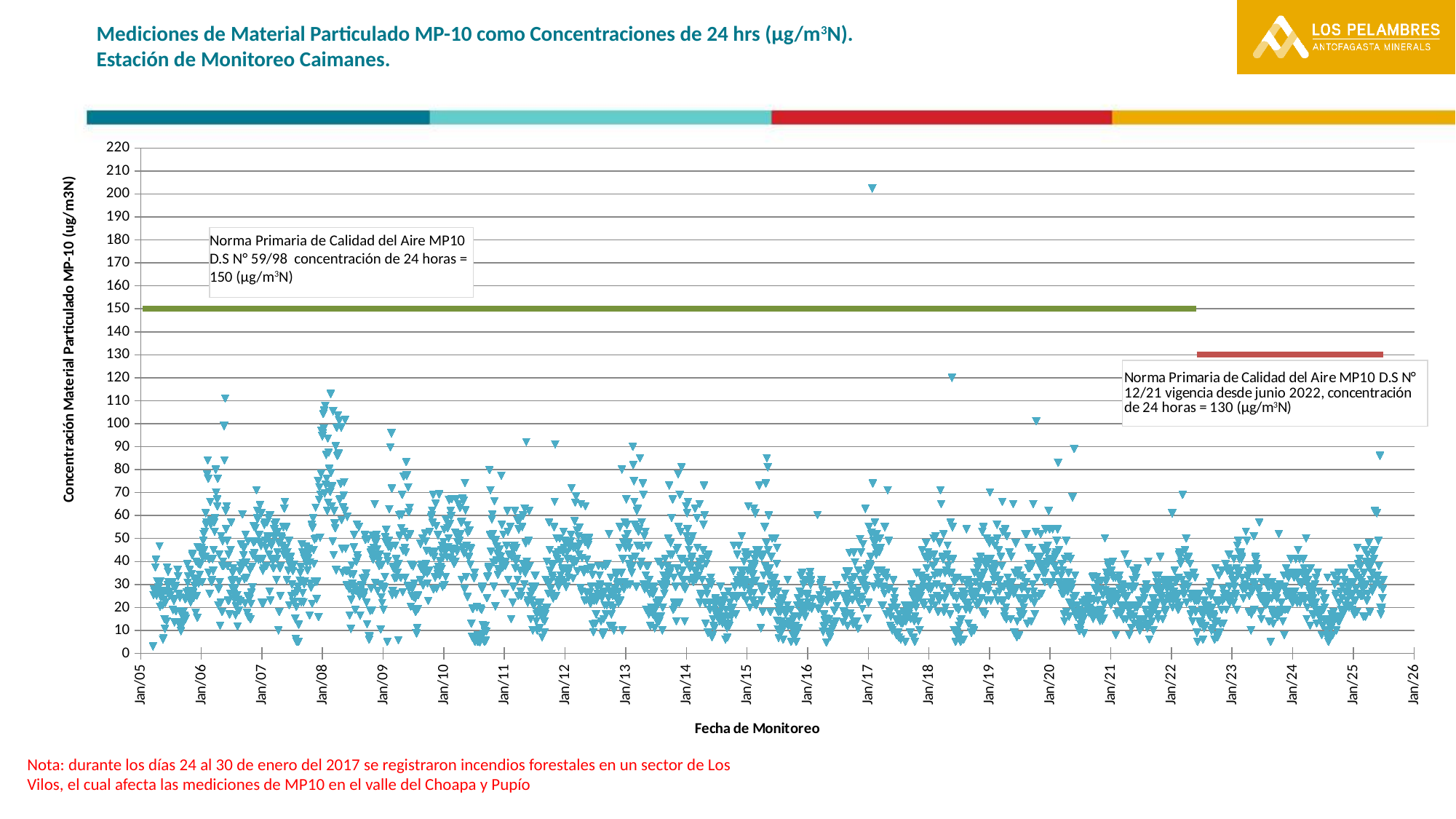
What is the label of the vertical axis? Concentración Material Particulado MP-10 (ug/m3N) What 24-hour concentration limit does the Norma Primaria de Calidad del Aire MP10 D.S N° 59/98 set, according to the chart annotation? 150 (µg/m³N) What is the difference between the D.S N° 59/98 limit (150) and the D.S N° 12/21 limit (130)? 20 What is the title of the chart? Mediciones de Material Particulado MP-10 como Concentraciones de 24 hrs (µg/m³N). Estación de Monitoreo Caimanes. What are the first and last labels on the horizontal axis? Jan/05 and Jan/26 What is the highest value shown on the vertical axis? 220 Is the highest measured point on the chart (around Jan/17) greater or less than 150? greater From when is the D.S N° 12/21 norm in force, according to the chart annotation? junio 2022 Which norm line is higher on the chart, the D.S N° 59/98 line or the D.S N° 12/21 line? D.S N° 59/98 Is the isolated high point near Jan/18 greater or less than 100? greater What kind of chart is shown on the slide? Scatter chart What 24-hour concentration limit does the Norma Primaria de Calidad del Aire MP10 D.S N° 12/21 set, according to the chart annotation? 130 (µg/m³N)